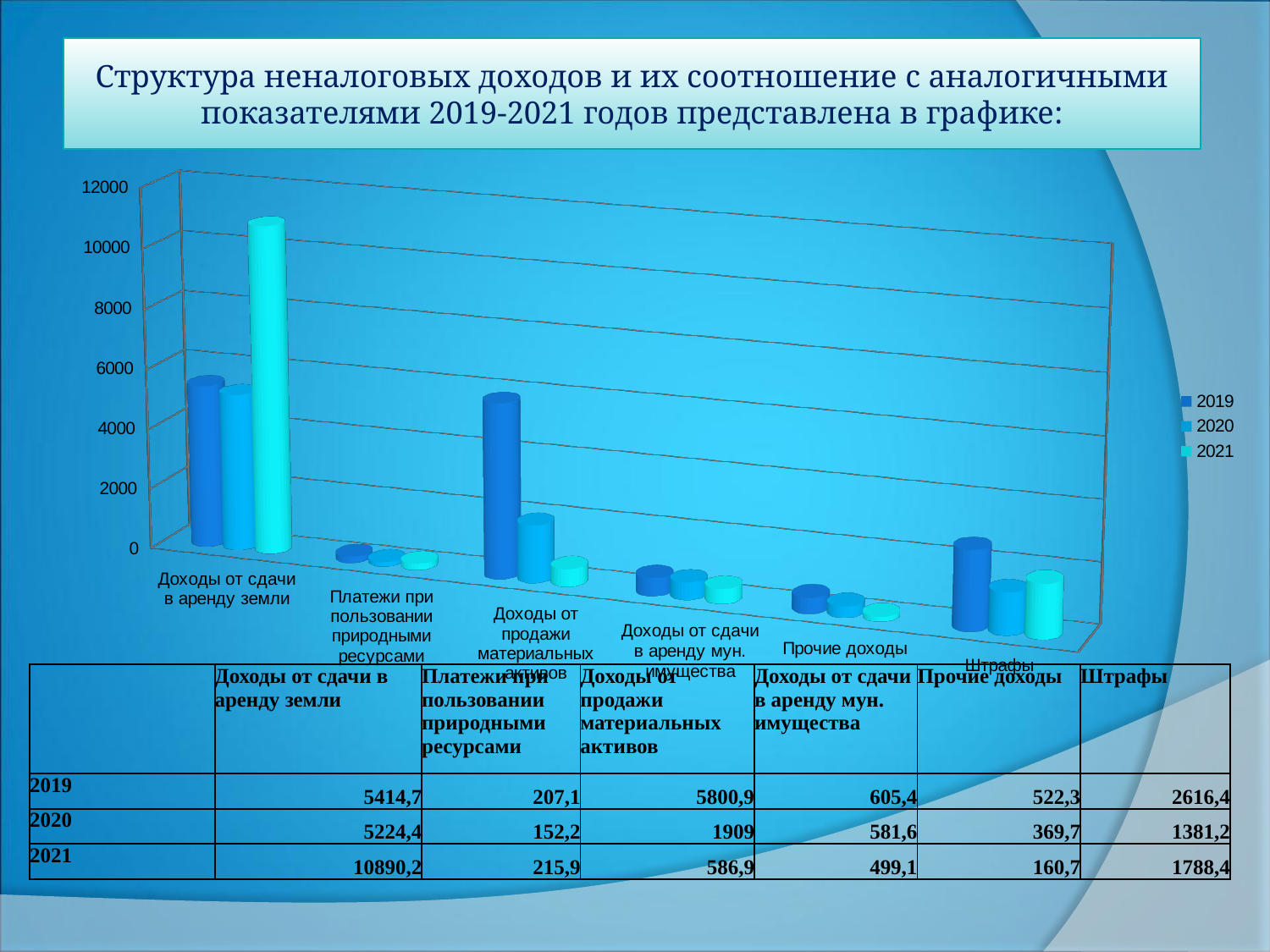
How many series does the legend list? 3 Which category has the highest value in 2021? Доходы от сдачи в аренду земли Which is larger for Доходы от продажи материальных активов: the 2019 value or the 2020 value? 2019 What is the difference between the 2021 and 2019 values for Доходы от сдачи в аренду земли? 5475,5 What is the value for Прочие доходы in 2021? 160,7 What type of chart is shown on the slide? bar chart Which category has the lowest value in 2019? Платежи при пользовании природными ресурсами Is the value for Доходы от сдачи в аренду земли in 2021 greater or less than 10000? greater What is the value for Доходы от продажи материальных активов in 2020? 1909 What is the value for Штрафы in 2019? 2616,4 How many categories are shown on the x axis of the chart? 6 What is the value for Доходы от сдачи в аренду земли in 2021? 10890,2